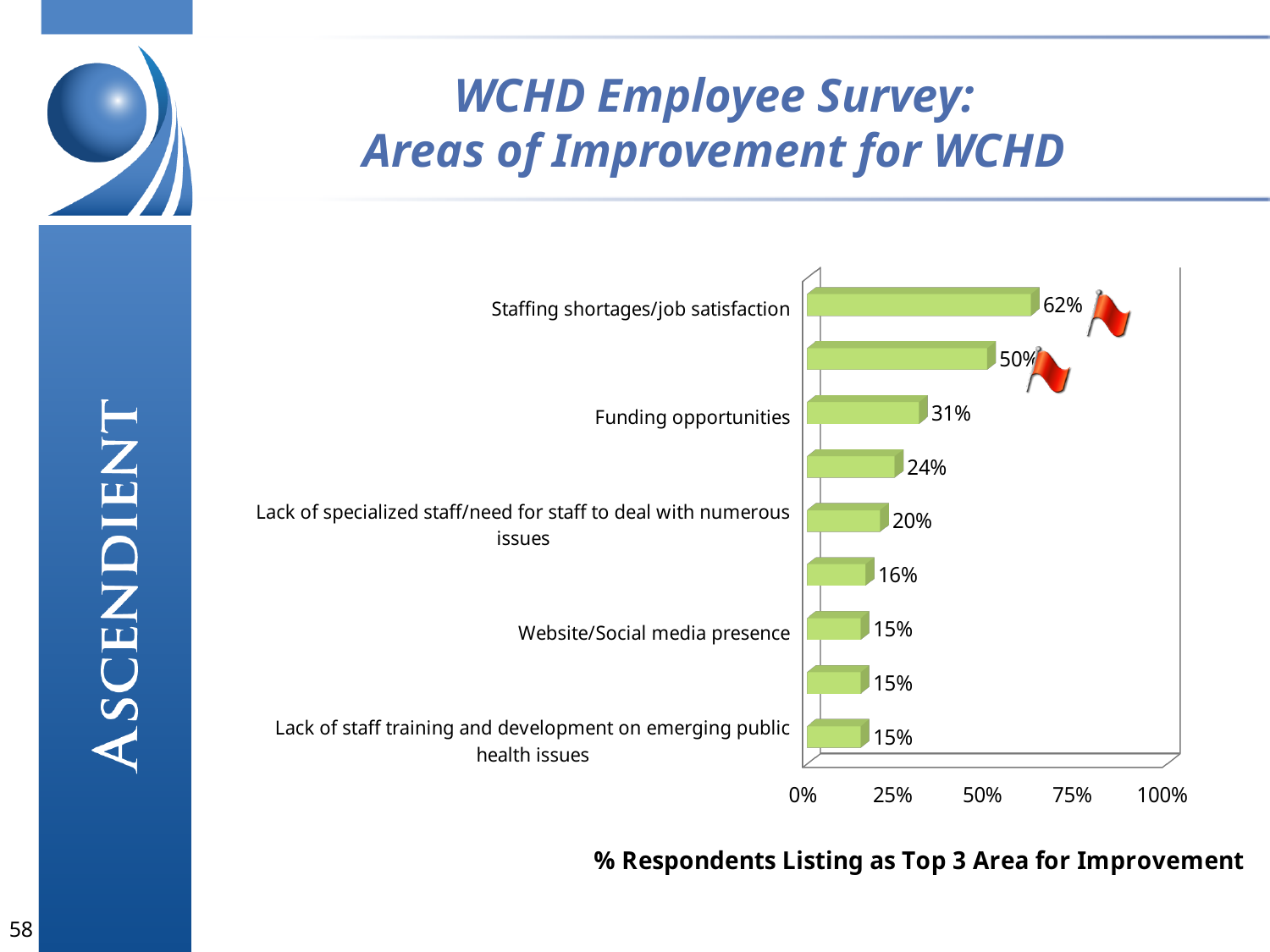
How many bars are plotted in the chart? 9 What is the difference in percentage points between Staffing shortages/job satisfaction and Funding opportunities? 31 percentage points What is the value shown for Website/Social media presence? 15% What is the label on the horizontal axis of the chart? % Respondents Listing as Top 3 Area for Improvement What percentage of respondents listed Staffing shortages/job satisfaction as a top 3 area for improvement? 62% Which area for improvement has the highest percentage of respondents? Staffing shortages/job satisfaction What is the value shown for Lack of specialized staff/need for staff to deal with numerous issues? 20% Is the value for Staffing shortages/job satisfaction greater or less than 50%? greater What is the value shown for Lack of staff training and development on emerging public health issues? 15% What is the value shown for Funding opportunities? 31% Which has a larger value: Funding opportunities or Website/Social media presence? Funding opportunities What kind of chart is shown on the slide? Bar chart